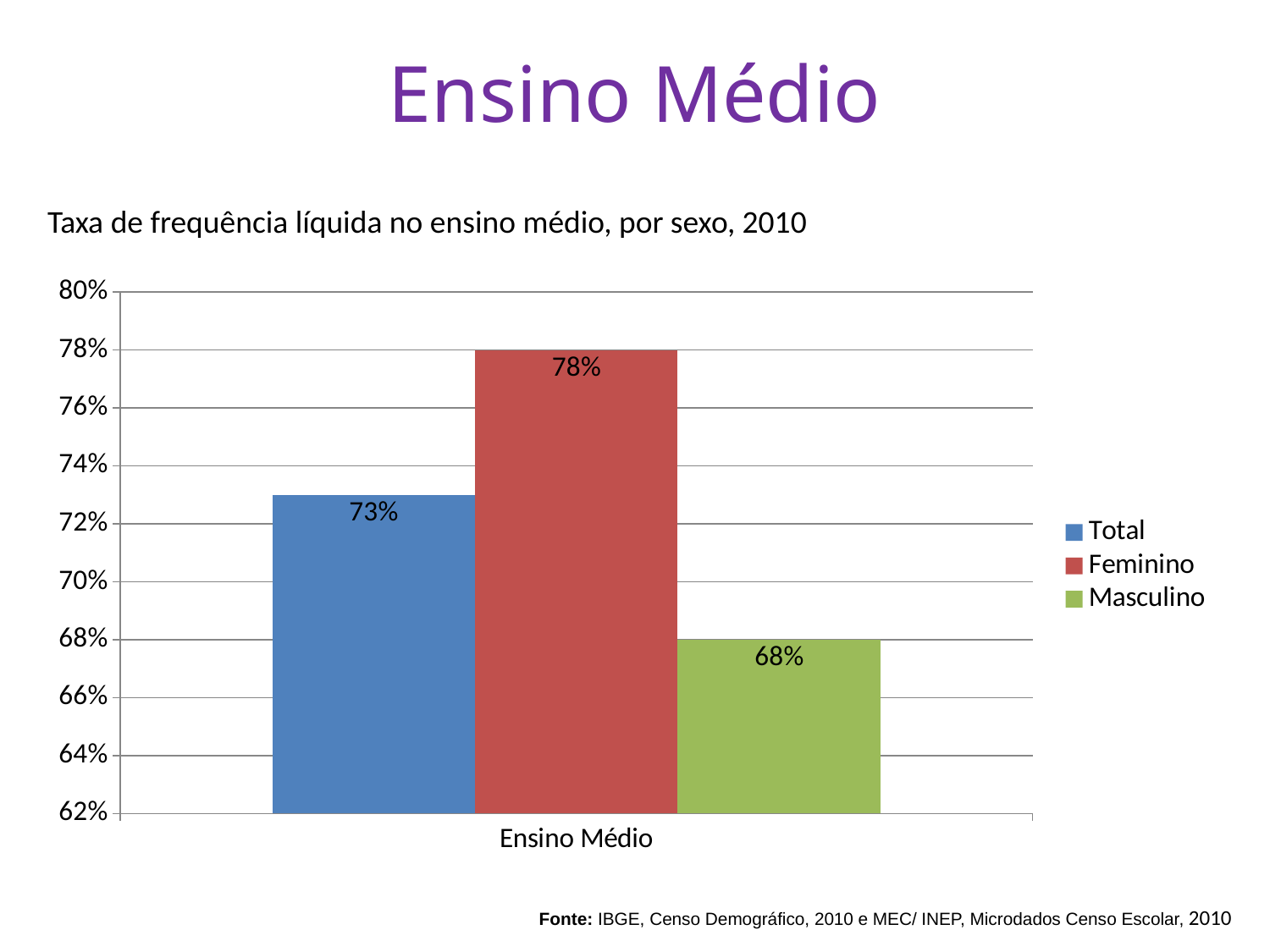
Is the value for Total greater or less than 70%? greater What colour is the bar for Feminino? Red Which is larger, the value for Total or the value for Masculino? Total What is the value for Masculino? 68% Which series has the highest value? Feminino Which series has the lowest value? Masculino What kind of chart is shown on the slide? Bar chart How many series does the legend list? 3 What is the difference between the Feminino and Masculino values? 10% What is the value for Total? 73% What is the difference between the Feminino and Total values? 5% What is the value for Feminino? 78%